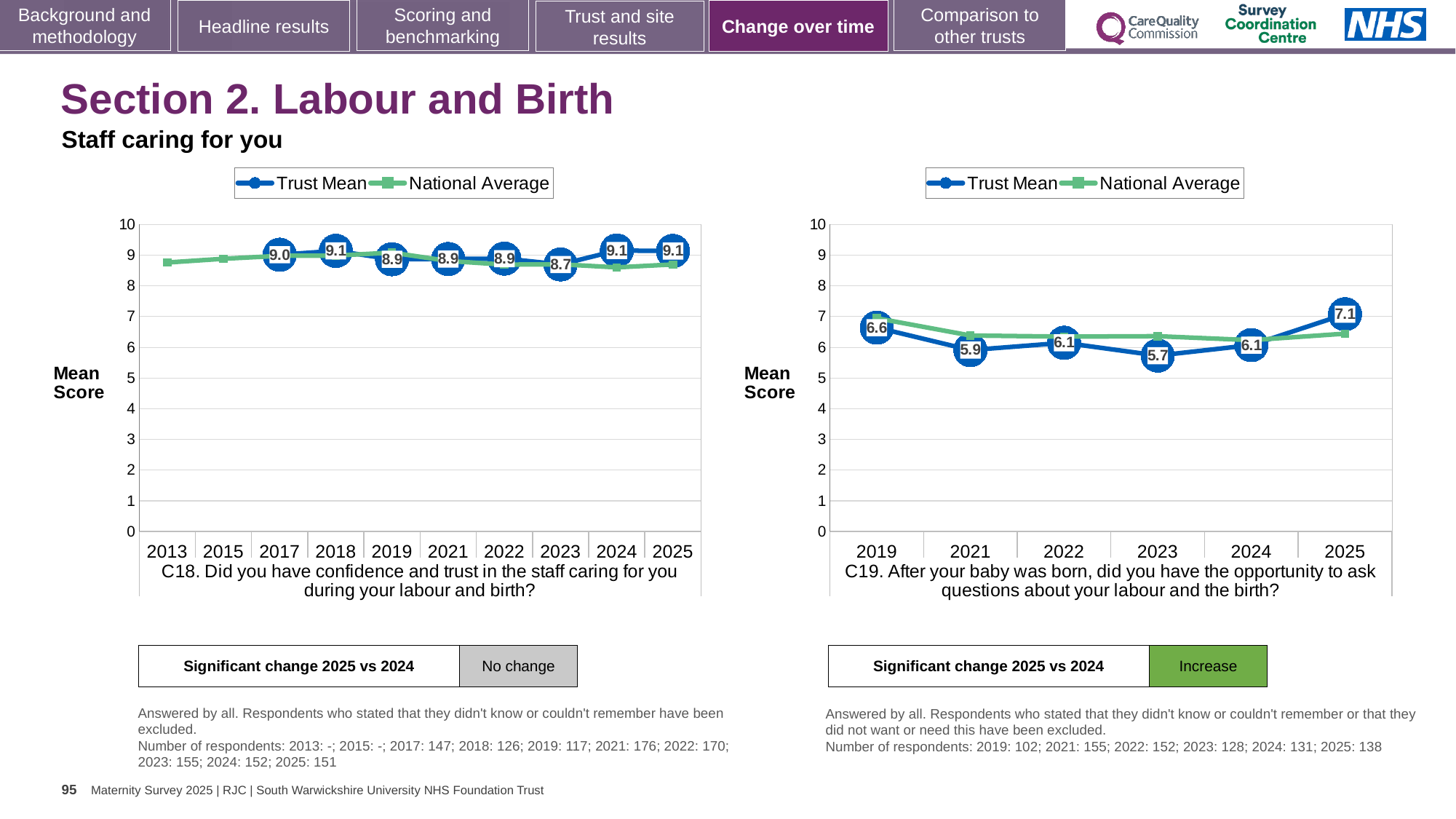
In the C19 chart (right), which year has the highest Trust Mean? 2025 In the C19 chart (right), what is the Trust Mean for 2025? 7.1 In the C18 chart (left), how many years are shown on the x axis? 10 In the C18 chart (left), which year has the lowest Trust Mean? 2023 In the C19 chart (right), is the Trust Mean for 2019 greater or less than the Trust Mean for 2021? greater In the C19 chart (right), what is the difference between the Trust Mean for 2025 and 2024? 1.0 In the C19 chart (right), which year has the lowest Trust Mean? 2023 In the C18 chart (left), what is the Trust Mean for 2025? 9.1 How many series does the legend of the C19 chart (right) list? 2 In the C18 chart (left), what is the difference between the Trust Mean for 2025 and 2023? 0.4 In the C18 chart (left), what is the Trust Mean for 2023? 8.7 In the C19 chart (right), what is the Trust Mean for 2023? 5.7